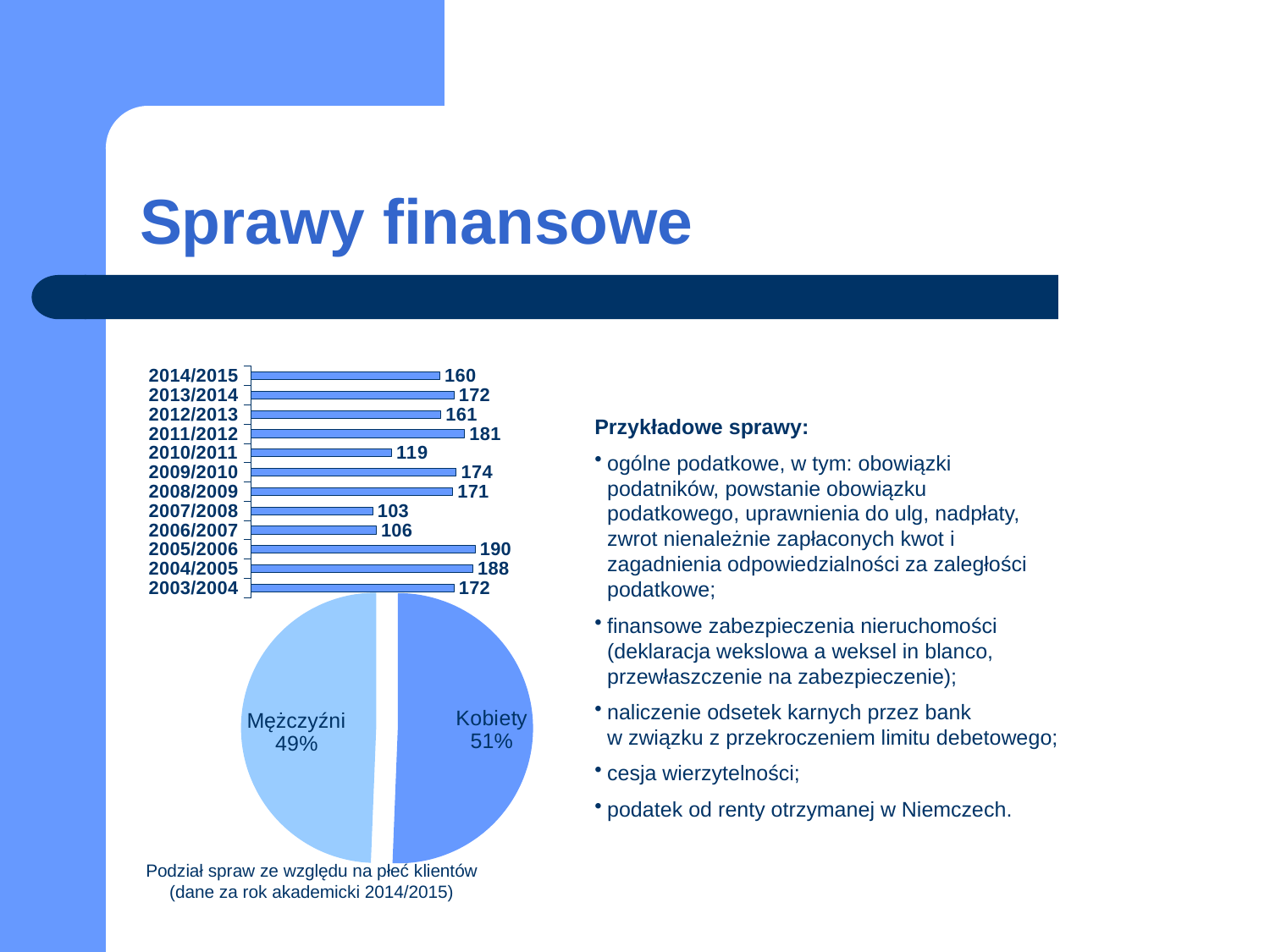
In the bar chart at the top left of the slide, which academic year has the lowest value? 2007/2008 In the pie chart below the bar chart, which slice is larger, Kobiety or Mężczyźni? Kobiety How many academic years are shown in the bar chart at the top left of the slide? 12 In the bar chart at the top left of the slide, what is the value for 2005/2006? 190 In the bar chart at the top left of the slide, what is the difference between the values for 2011/2012 and 2010/2011? 62 In the bar chart at the top left of the slide, which is larger, the value for 2004/2005 or the value for 2013/2014? 2004/2005 In the bar chart at the top left of the slide, what is the value for 2014/2015? 160 What kind of chart is the chart at the top left of the slide showing values by academic year? bar chart In the bar chart at the top left of the slide, which academic year has the highest value? 2005/2006 What is the caption printed under the pie chart on the slide? Podział spraw ze względu na płeć klientów (dane za rok akademicki 2014/2015) In the bar chart at the top left of the slide, what is the value for 2010/2011? 119 In the pie chart below the bar chart, what share is labelled Kobiety? 51%